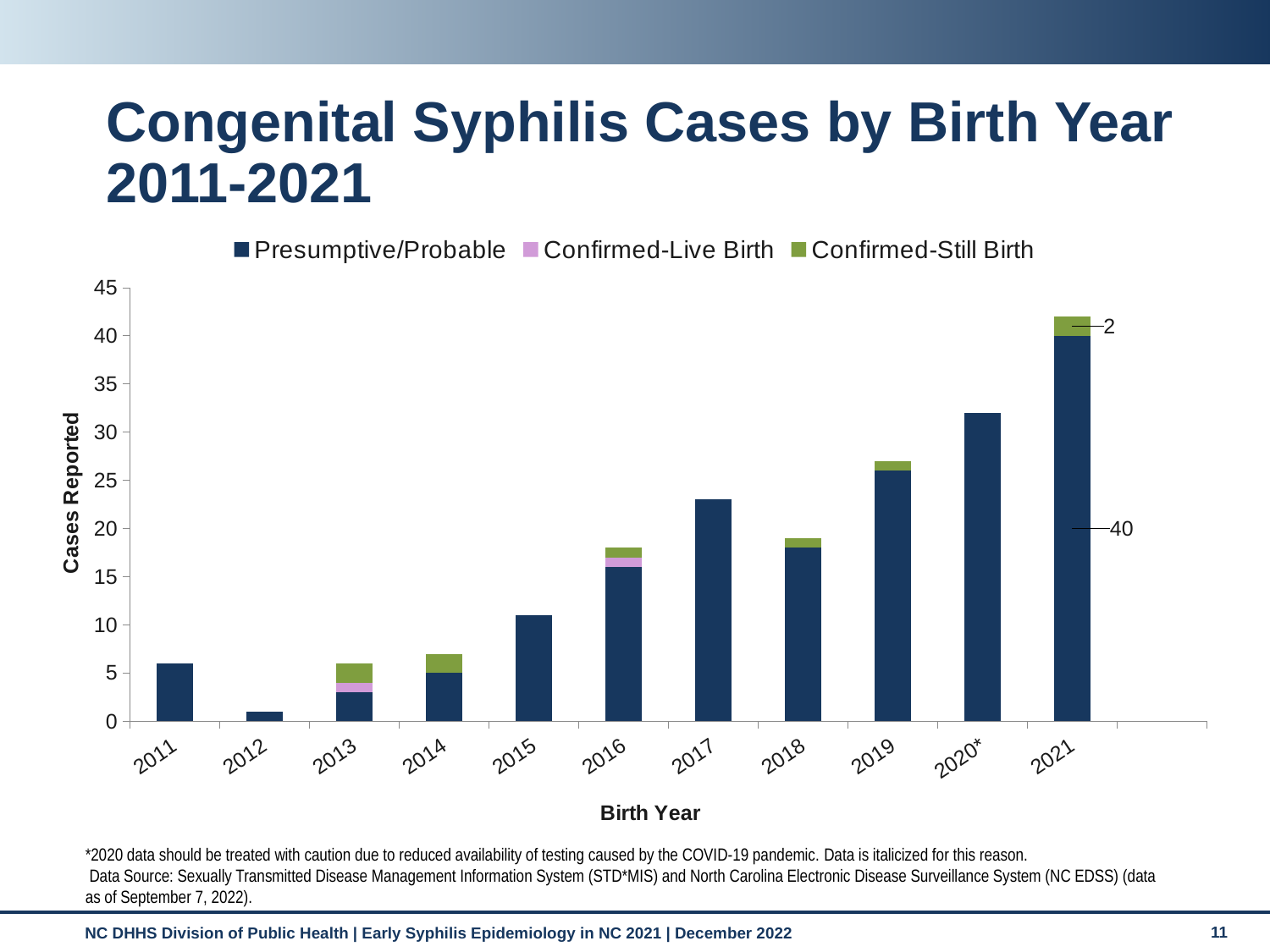
What is the Presumptive/Probable value for 2021? 40 Is the value for 2020* greater or less than 30? greater Do the cases reported generally rise or fall from 2011 to 2021? Rise How many series does the legend list? 3 Which birth year has the lowest total cases reported? 2012 What is the total height of the stacked bar for 2021? 42 How many birth years are shown on the x axis? 11 What kind of chart is shown on the slide? Bar chart Which birth year has a taller bar, 2018 or 2019? 2019 Is the value for 2017 greater or less than 20? greater What is the Confirmed-Still Birth value for 2021? 2 Which birth year has the highest total cases reported? 2021